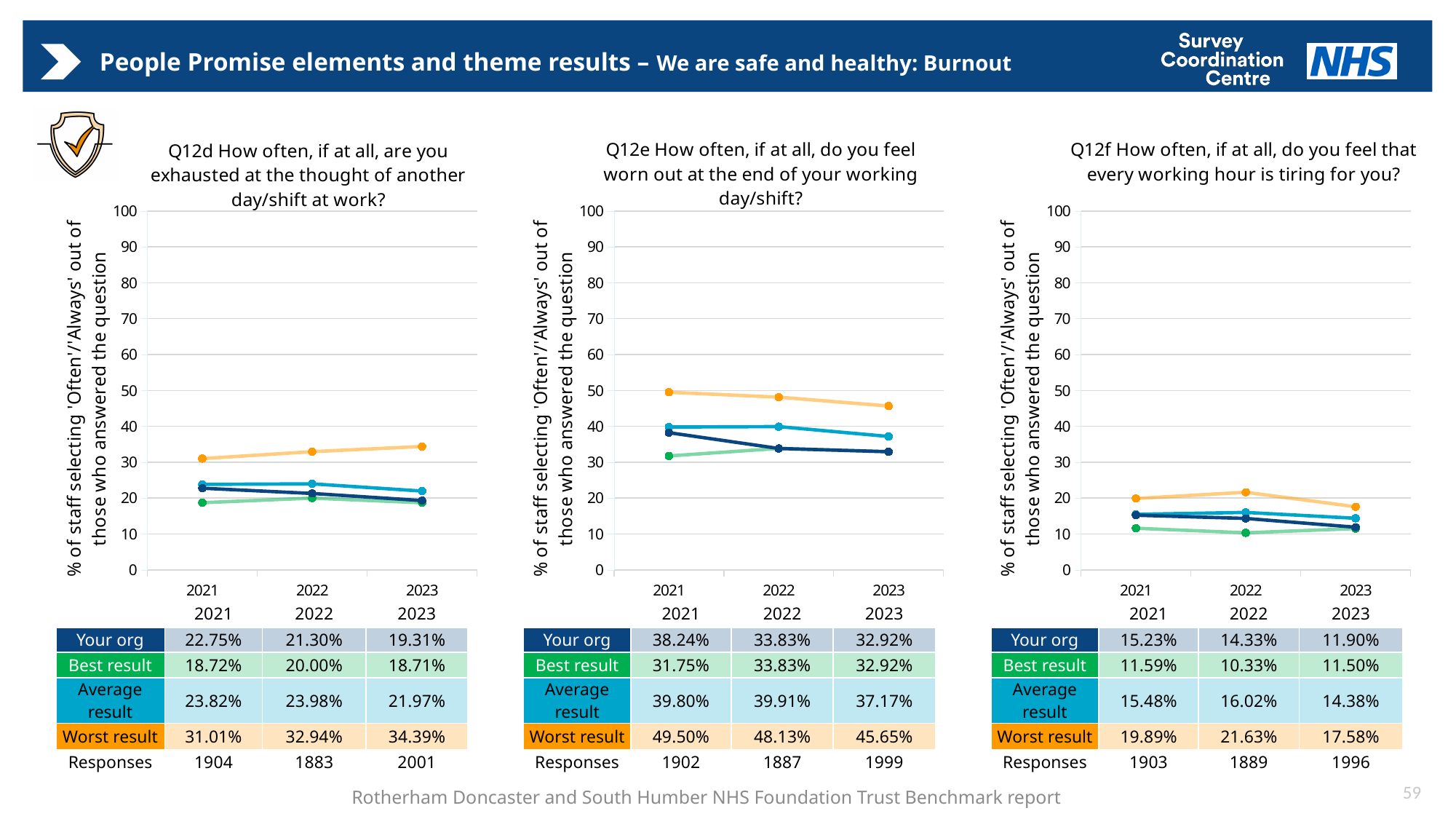
How many series are plotted in the Q12d chart? 4 How many years are shown on the x axis of the Q12f chart? 3 In the Q12e chart, what is the 'Worst result' value for 2021? 49.50% In the Q12e chart, does the 'Worst result' series rise or fall from 2021 to 2023? Fall In the Q12e chart, what is the difference between the 'Average result' and 'Your org' values for 2021? 1.56% What type of chart is used for Q12e? Line chart In the Q12f chart, which year has the lowest 'Your org' value? 2023 In the Q12e chart, is the 'Worst result' value for 2023 greater or less than 40? greater In the Q12f chart, what is the 'Average result' value for 2022? 16.02% In the Q12d chart, which year has the highest 'Worst result' value? 2023 In the Q12d chart, which is larger in 2022: the 'Your org' value or the 'Average result' value? Average result In the Q12d chart, what is the 'Your org' value for 2023? 19.31%